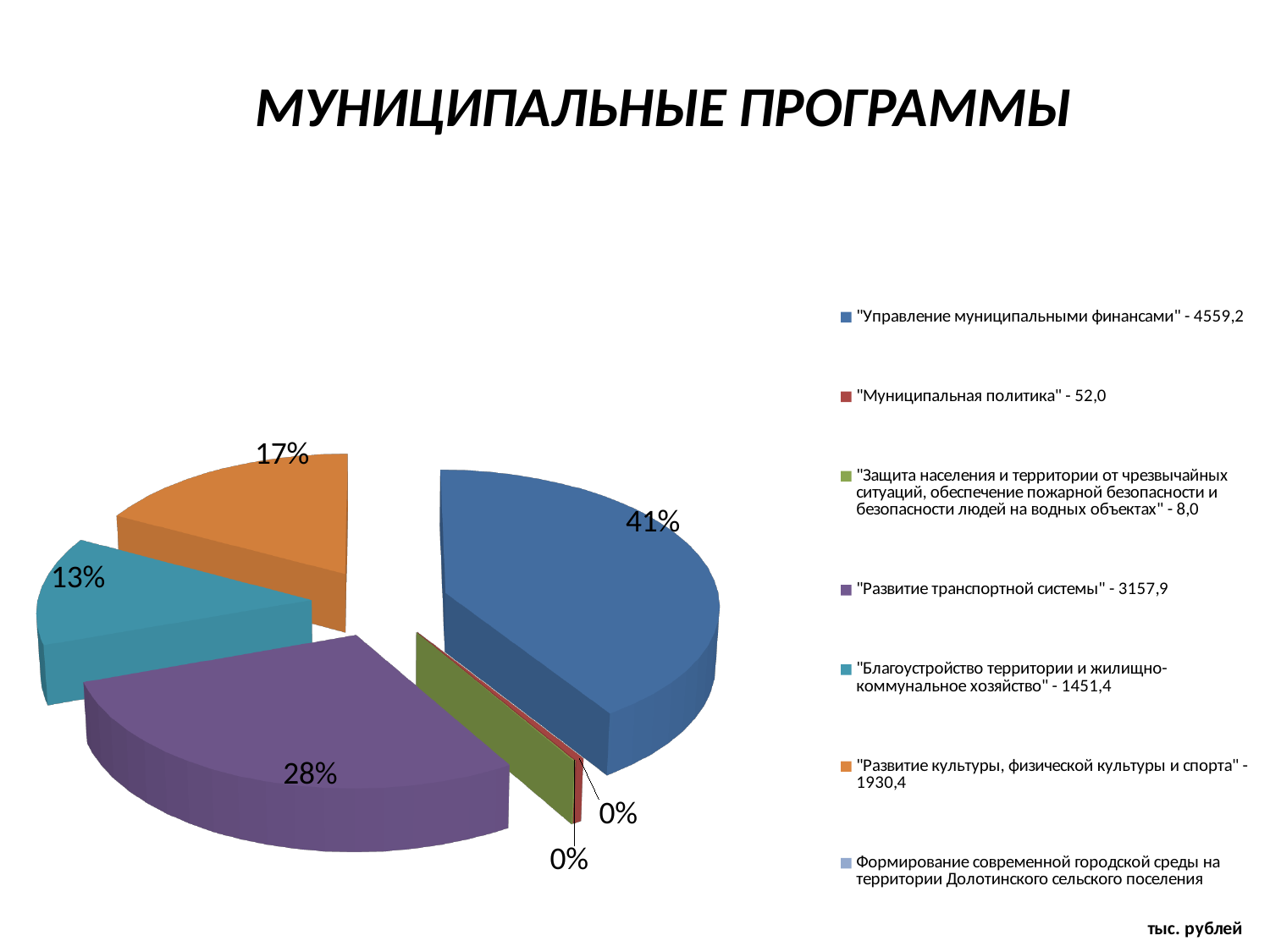
What share of the pie does "Управление муниципальными финансами" take? 41% What share of the pie does "Развитие транспортной системы" take? 28% What kind of chart is shown on the slide? pie chart Which is larger: the share for "Развитие культуры, физической культуры и спорта" or the share for "Благоустройство территории и жилищно-коммунальное хозяйство"? "Развитие культуры, физической культуры и спорта" Which programme has the largest slice of the pie? "Управление муниципальными финансами" What share of the pie does "Развитие культуры, физической культуры и спорта" take? 17% How many entries does the legend list? 7 What amount is shown in the legend for "Муниципальная политика"? 52,0 What is the difference in percentage points between the share for "Управление муниципальными финансами" and the share for "Развитие транспортной системы"? 13 percentage points What amount is shown in the legend for "Развитие транспортной системы"? 3157,9 What is the title of the chart? МУНИЦИПАЛЬНЫЕ ПРОГРАММЫ